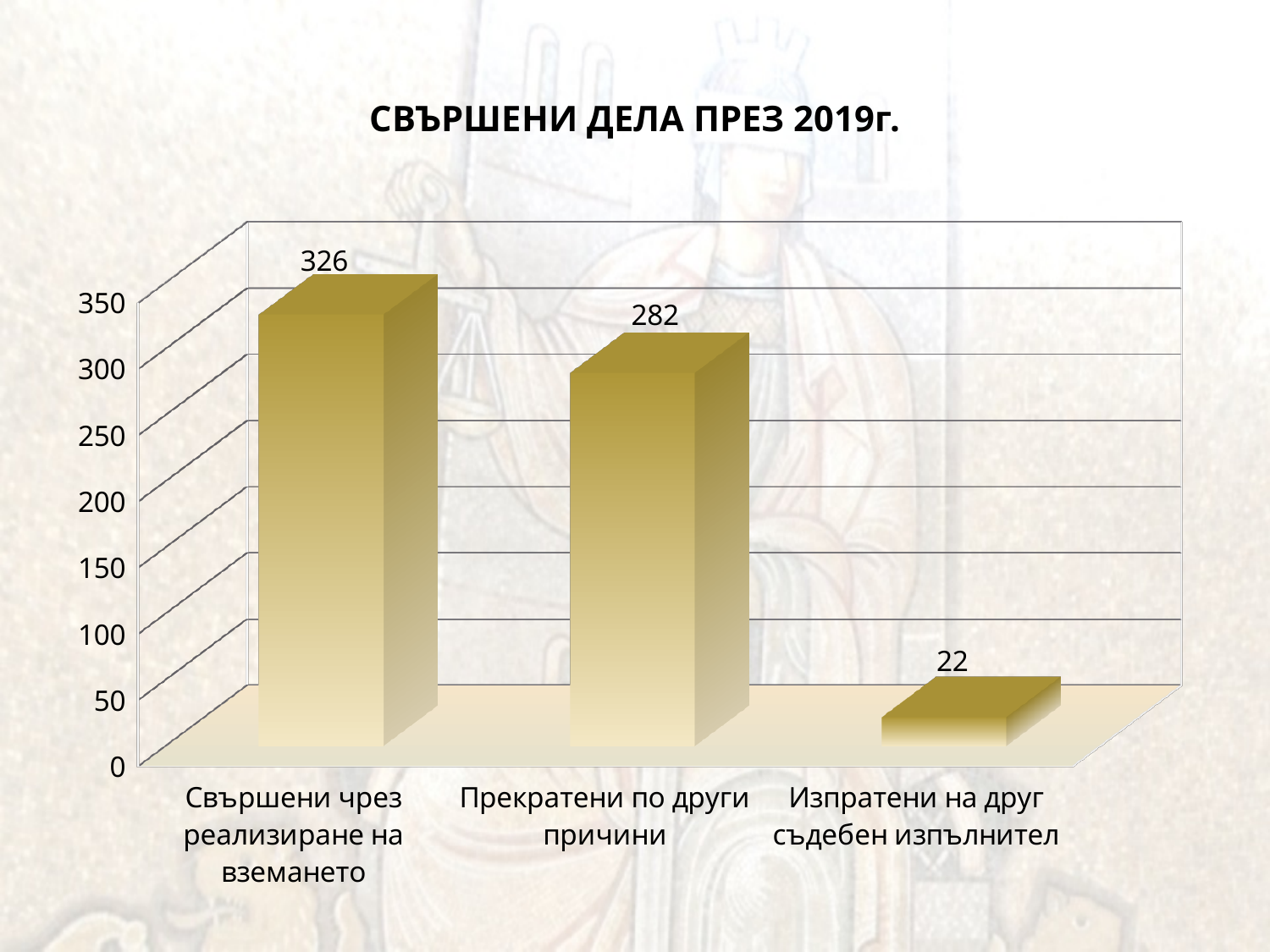
What is the difference between the values for "Свършени чрез реализиране на вземането" and "Прекратени по други причини"? 44 Which category has the highest value? Свършени чрез реализиране на вземането Is the value for "Прекратени по други причини" greater or less than 250? greater Which is larger: the value for "Прекратени по други причини" or the value for "Изпратени на друг съдебен изпълнител"? Прекратени по други причини Which category has the lowest value? Изпратени на друг съдебен изпълнител What is the difference between the values for "Прекратени по други причини" and "Изпратени на друг съдебен изпълнител"? 260 What is the title of the chart? СВЪРШЕНИ ДЕЛА ПРЕЗ 2019г. What is the value for "Изпратени на друг съдебен изпълнител"? 22 What kind of chart is shown on the slide? bar chart How many categories are shown in the chart? 3 What is the value for "Прекратени по други причини"? 282 What is the value for "Свършени чрез реализиране на вземането"? 326